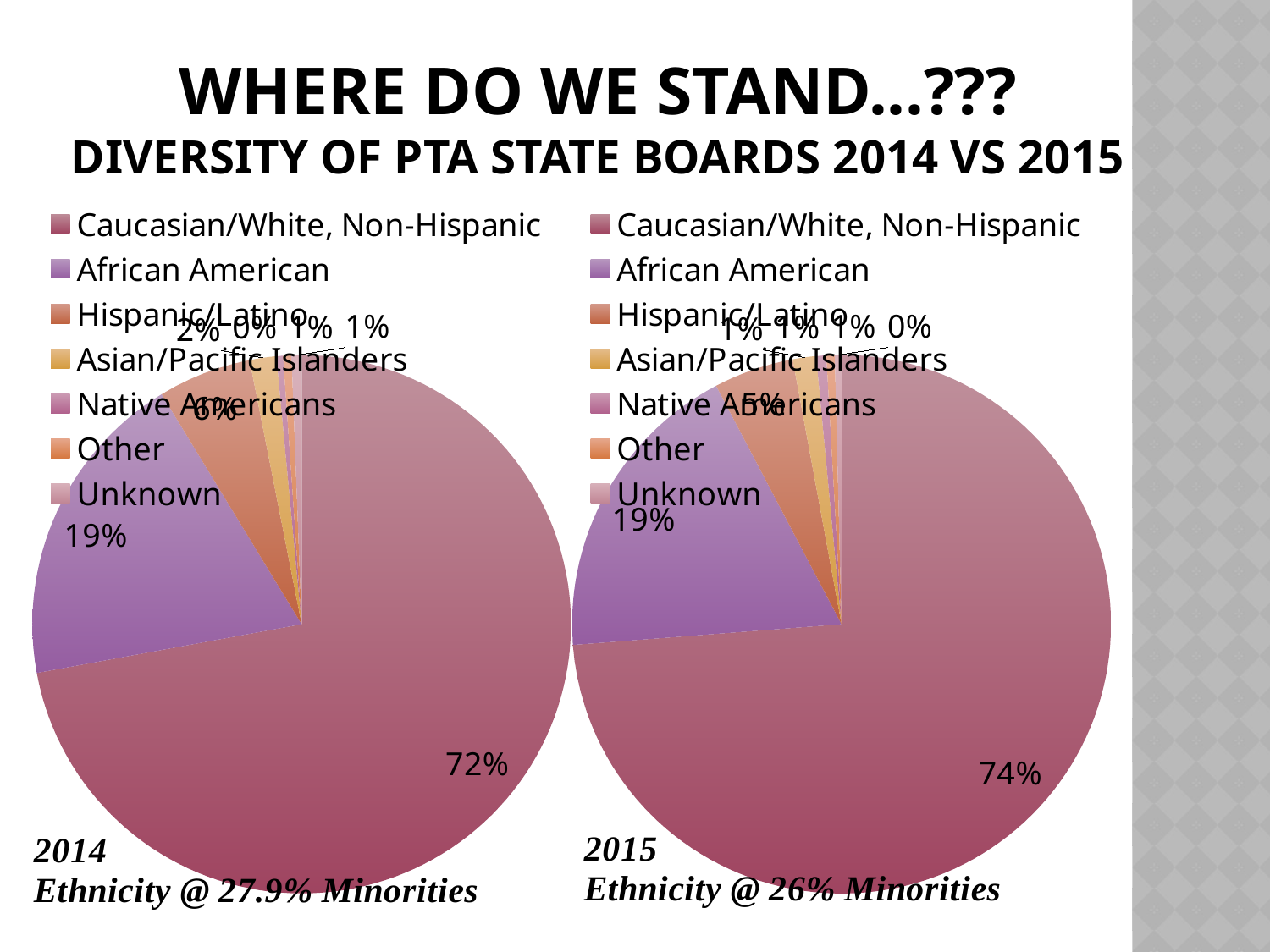
According to the caption under the 2014 pie chart, what percentage of the board were minorities? 27.9% In the 2014 pie chart, what share is shown for Caucasian/White, Non-Hispanic? 72% In the 2015 pie chart, what share is shown for Caucasian/White, Non-Hispanic? 74% In the 2014 pie chart, what share is shown for African American? 19% How many pie charts are shown on the slide? 2 In the 2014 pie chart, which category has the largest slice? Caucasian/White, Non-Hispanic In the 2014 pie chart, how many percentage points larger is the Caucasian/White, Non-Hispanic share than the African American share? 53 percentage points In the 2015 pie chart, what share is shown for Hispanic/Latino? 5% Is the Caucasian/White, Non-Hispanic share larger in the 2014 pie chart or the 2015 pie chart? 2015 How many categories does the legend of the 2014 pie chart list? 7 What kind of chart is used on this slide for the 2014 and 2015 data? Pie chart In the 2014 pie chart, what share is shown for Hispanic/Latino? 6%